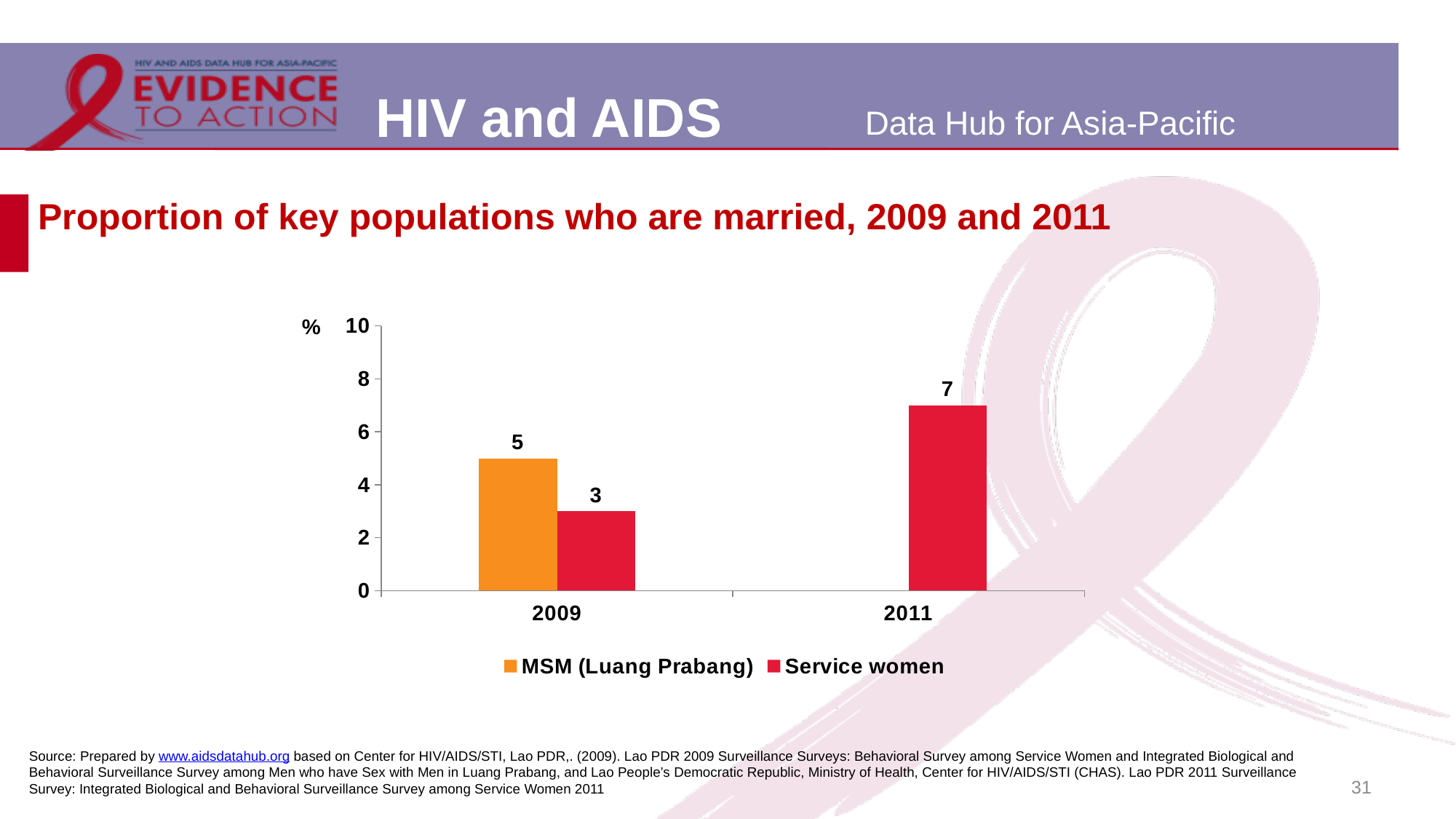
Which bar has the lowest value on the chart? Service women in 2009 How many years are shown on the x axis? 2 What kind of chart is shown on the slide? bar chart What is the value for Service women in 2009? 3 How many series does the legend list? 2 What is the difference between the Service women values in 2011 and 2009? 4 What is the value for Service women in 2011? 7 What is the difference between the MSM (Luang Prabang) and Service women values in 2009? 2 What is the value for MSM (Luang Prabang) in 2009? 5 In 2009, which is larger: MSM (Luang Prabang) or Service women? MSM (Luang Prabang) Does the Service women value rise or fall from 2009 to 2011? rise Which bar has the highest value on the chart? Service women in 2011